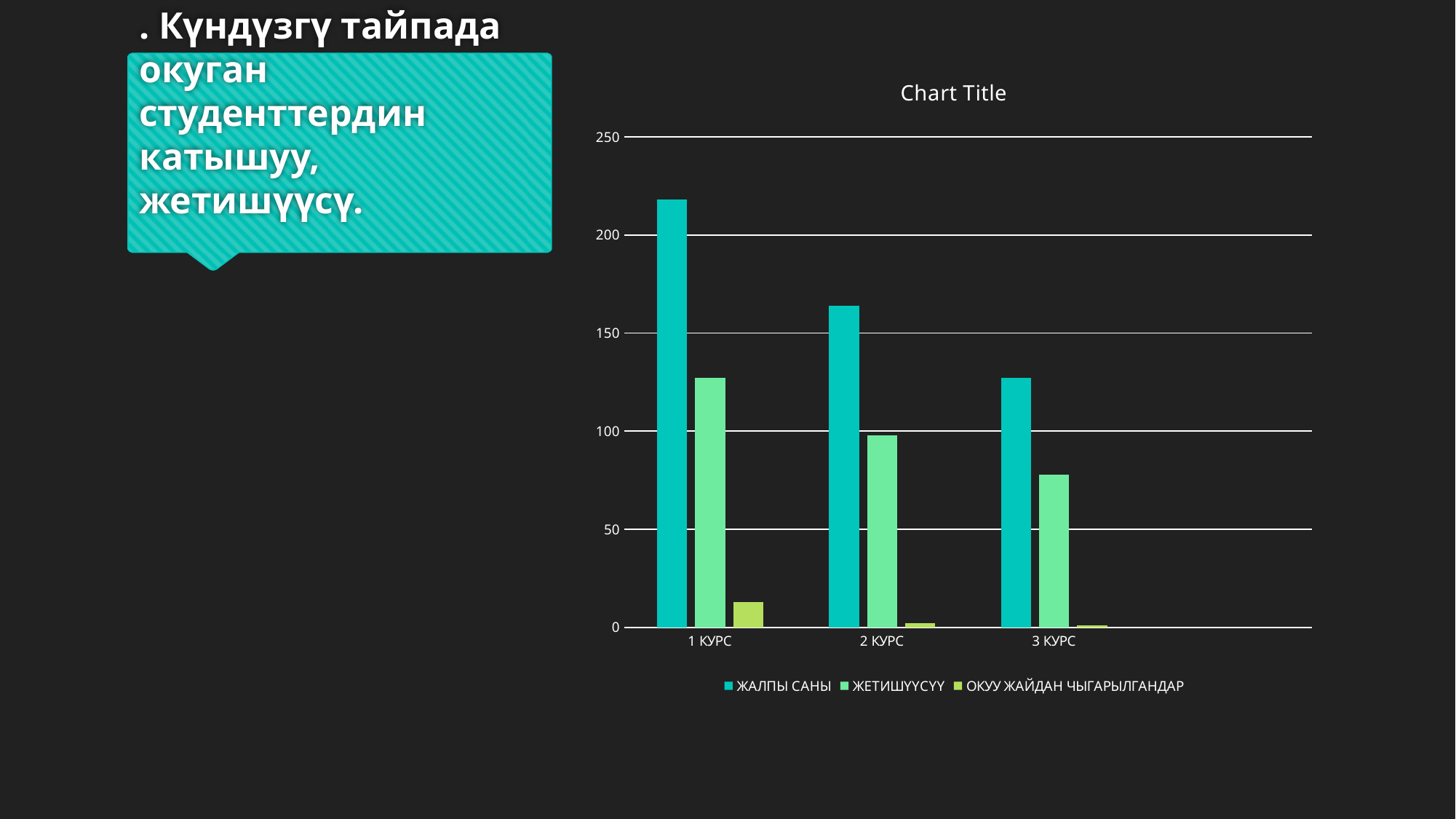
Which is larger: ЖЕТИШҮҮСҮҮ at 1 КУРС or ЖЕТИШҮҮСҮҮ at 3 КУРС? ЖЕТИШҮҮСҮҮ at 1 КУРС Which category has the lowest value for ЖЕТИШҮҮСҮҮ? 3 КУРС Is the value for ЖАЛПЫ САНЫ at 3 КУРС greater or less than 150? less Is the value for ЖАЛПЫ САНЫ at 1 КУРС greater or less than 200? greater What kind of chart is shown on the slide? bar chart Is the value for ОКУУ ЖАЙДАН ЧЫГАРЫЛГАНДАР at 1 КУРС greater or less than 50? less How many categories are shown on the x axis? 3 What is the title of the chart? Chart Title How many series does the legend list? 3 Which category has the highest value for ЖАЛПЫ САНЫ? 1 КУРС Do the values for ЖАЛПЫ САНЫ rise or fall from 1 КУРС to 3 КУРС? fall